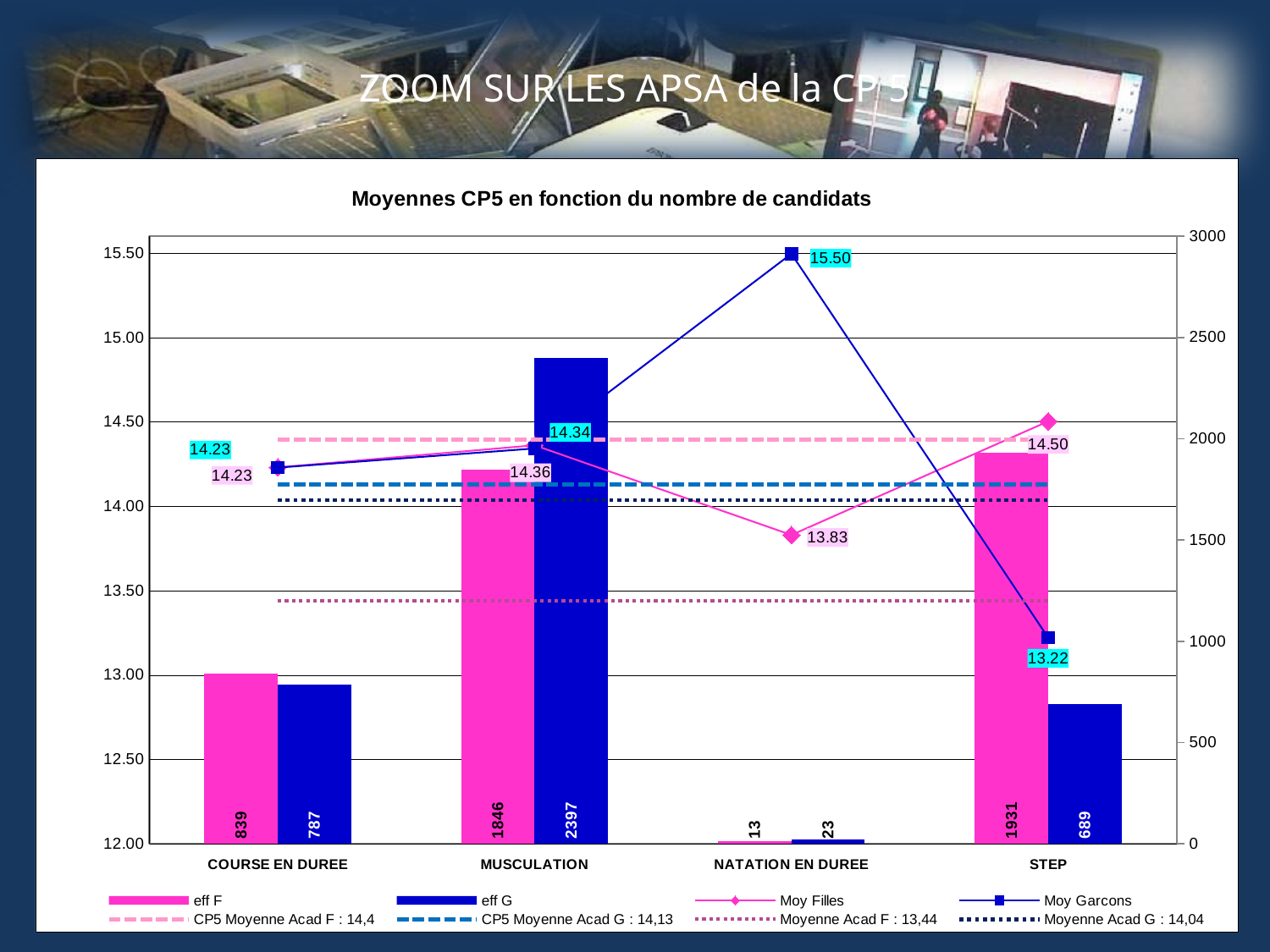
How many categories are shown on the x axis? 4 What is the difference between the eff G and eff F values for MUSCULATION? 551 Which category has the lowest Moy Garcons value? STEP What is the Moy Filles value for STEP? 14.50 What is the eff F value for MUSCULATION? 1846 Which is larger for COURSE EN DUREE, eff F or eff G? eff F What is the title of the chart? Moyennes CP5 en fonction du nombre de candidats How many series does the legend list? 8 What is the Moy Garcons value for NATATION EN DUREE? 15.50 What is the eff G value for STEP? 689 Which category has the highest eff G value? MUSCULATION What is the Moy Filles value for NATATION EN DUREE? 13.83